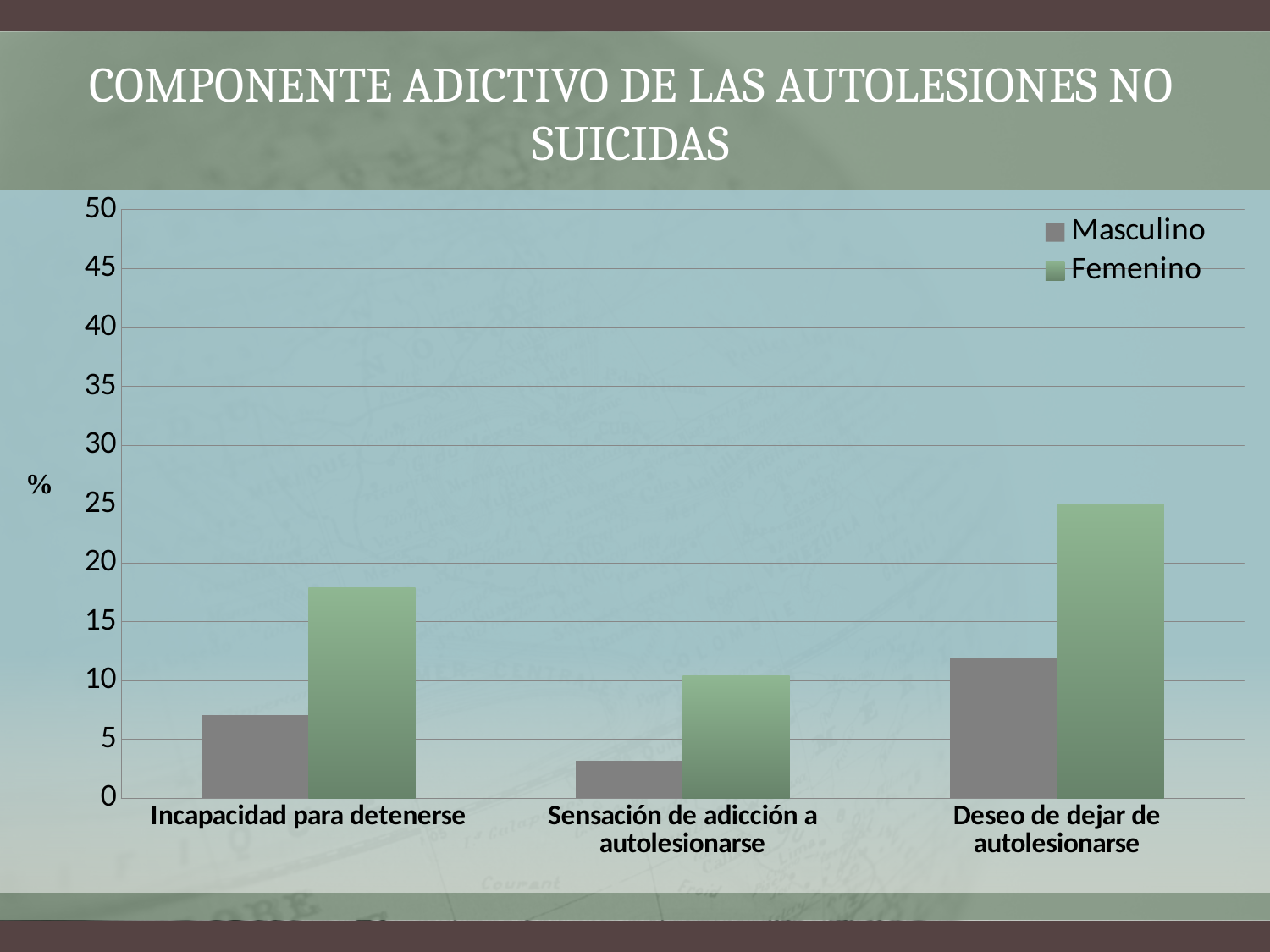
What kind of chart is shown on the slide? bar chart How many series does the legend list? 2 Is the Masculino value for Deseo de dejar de autolesionarse greater or less than 10? greater What is the title of the chart? COMPONENTE ADICTIVO DE LAS AUTOLESIONES NO SUICIDAS Is the Femenino value for Incapacidad para detenerse greater or less than 15? greater What label is shown on the vertical axis? % Which category has the lowest Masculino value? Sensación de adicción a autolesionarse Is the Femenino value for Sensación de adicción a autolesionarse greater or less than 15? less Which category has the highest Femenino value? Deseo de dejar de autolesionarse For Incapacidad para detenerse, which series has the larger value, Masculino or Femenino? Femenino How many categories are shown on the x axis? 3